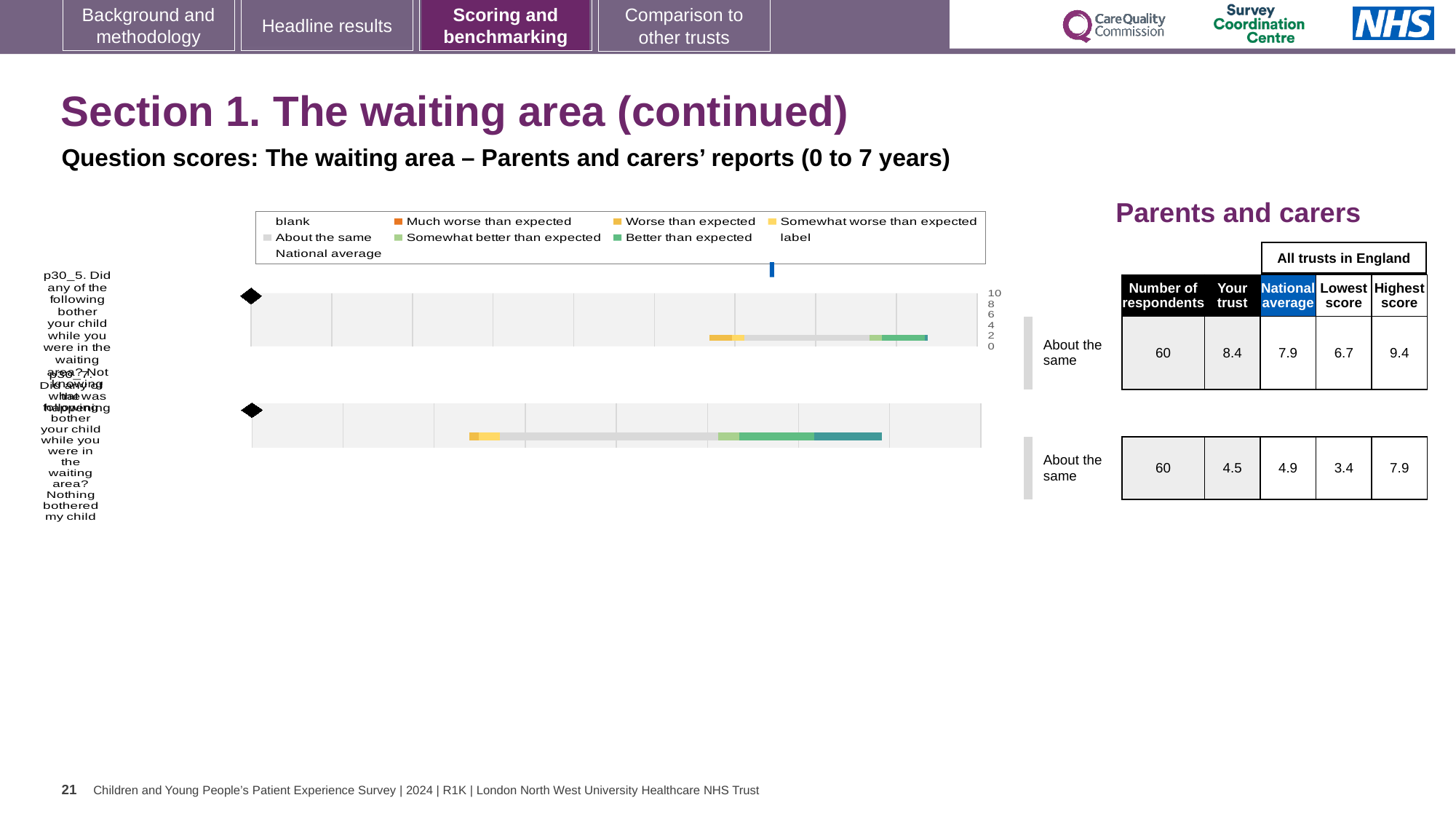
In the table beside the chart, what is the national average for the second question (p30_7, Nothing bothered my child)? 4.9 In the table beside the chart, how many respondents answered the first question (p30_5)? 60 In the table beside the chart, what is the difference between the highest and lowest scores for the second question (p30_7)? 4.5 How many bars (question rows) are plotted in the chart? 2 In the table beside the chart, what is the highest score among all trusts in England for the first question (p30_5)? 9.4 Which legend entry is shown in grey in the chart? About the same In the table beside the chart, what is the 'Your trust' score for the first question (p30_5, Not knowing what was happening)? 8.4 In the table beside the chart, what is the difference between the highest and lowest scores for the first question (p30_5)? 2.7 In the table beside the chart, for the second question (p30_7), which is larger: the 'Your trust' score or the national average? National average What kind of chart is shown on the slide? bar chart How many entries does the chart legend list? 9 What is the highest value shown on the chart's axis? 10